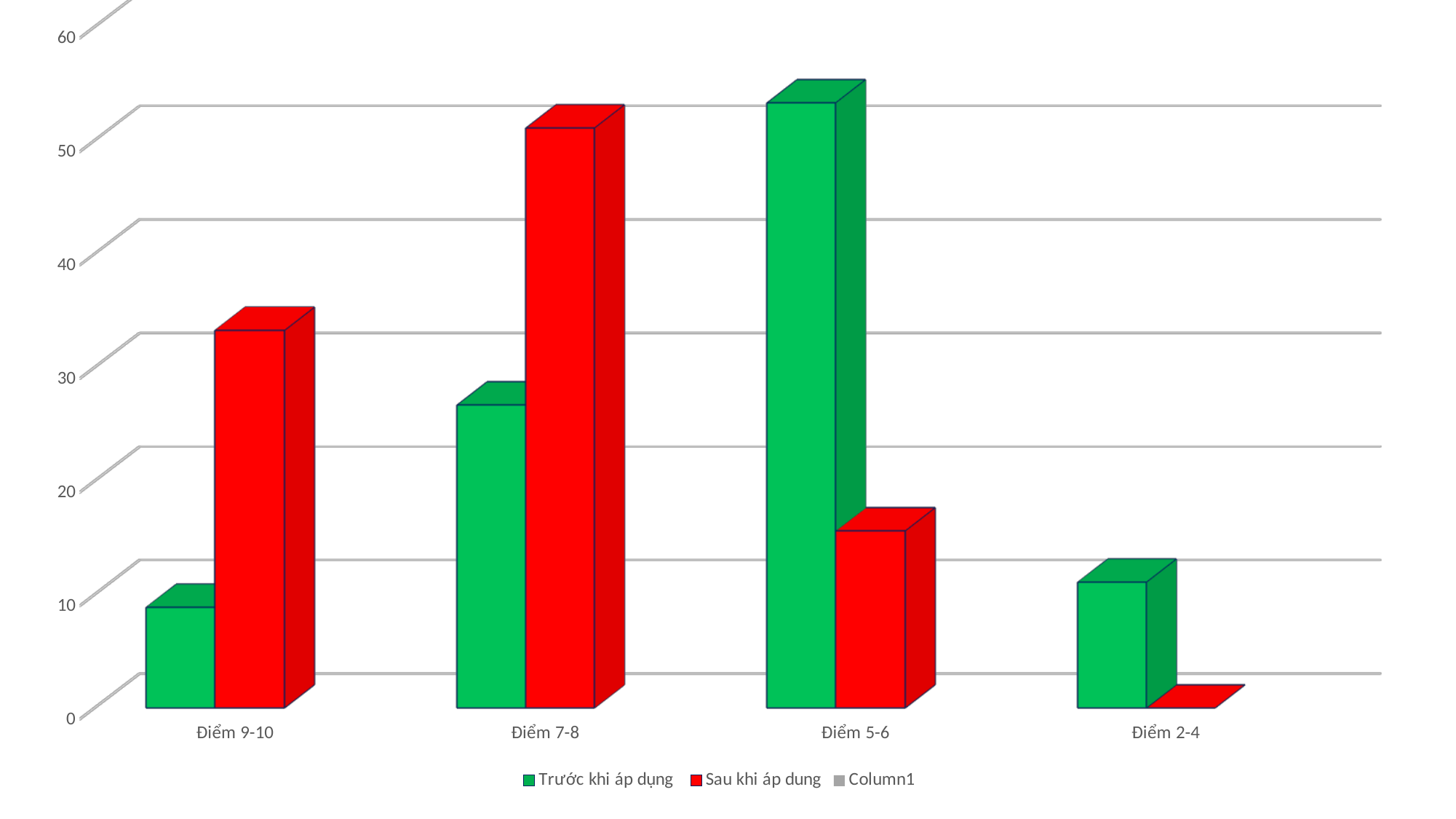
Is the value for Trước khi áp dụng at Điểm 7-8 greater or less than 30? less What kind of chart is shown on the slide? bar chart For Điểm 5-6, which series has the larger value, Trước khi áp dụng or Sau khi áp dung? Trước khi áp dụng Which category has the highest value for the series Trước khi áp dụng? Điểm 5-6 Is the value for Sau khi áp dung at Điểm 5-6 greater or less than 20? less How many series does the legend list? 3 What colour represents the series Sau khi áp dung in the legend? red How many categories are shown on the x axis? 4 For Điểm 9-10, which series has the larger value, Trước khi áp dụng or Sau khi áp dung? Sau khi áp dung Which category has the highest value for the series Sau khi áp dung? Điểm 7-8 Is the value for Sau khi áp dung at Điểm 9-10 greater or less than 30? greater Which category has the lowest value for the series Sau khi áp dung? Điểm 2-4